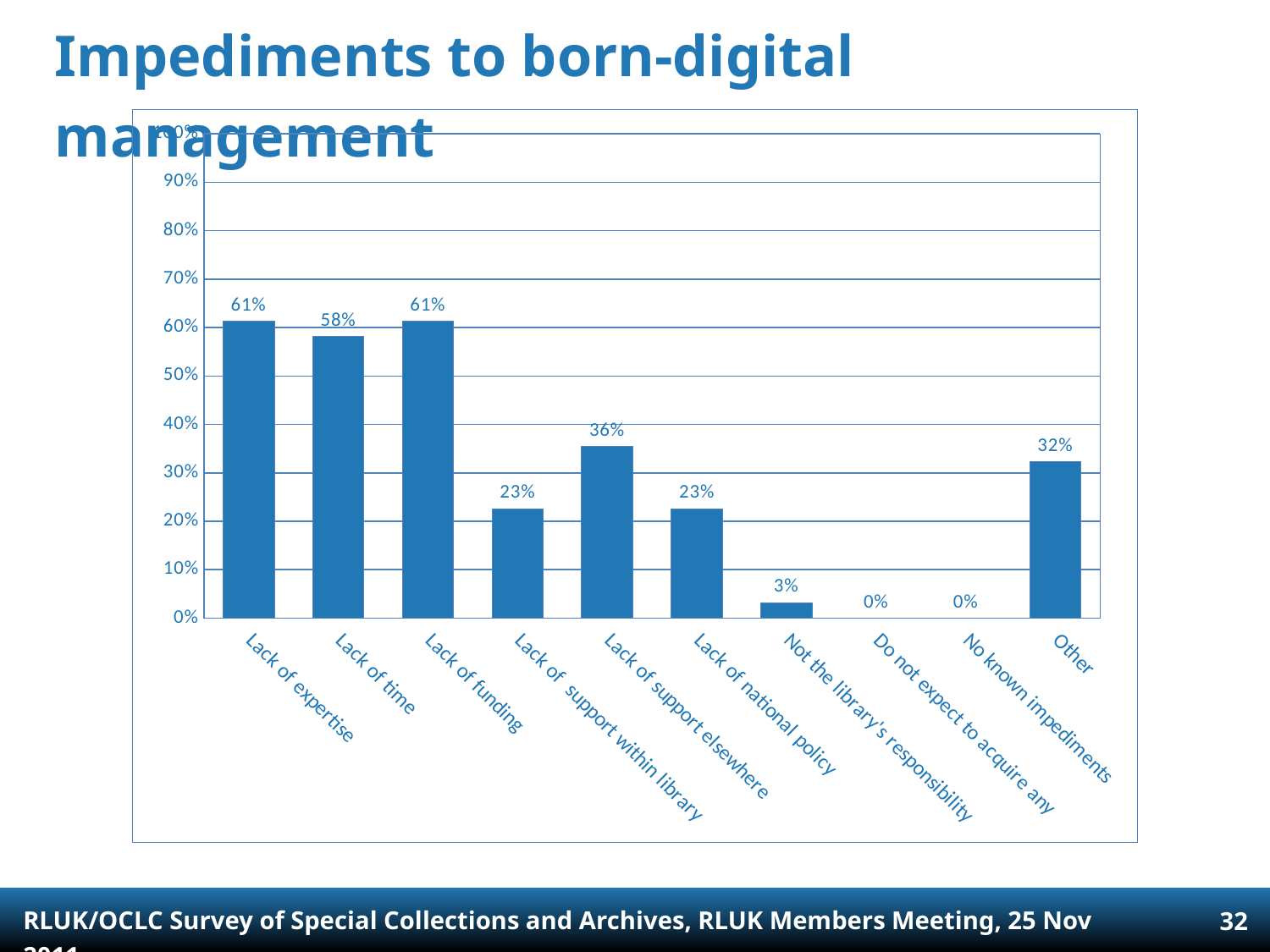
What is the value for Other? 32% How many categories are shown on the x axis? 10 Is the value for Lack of time greater or less than 50%? greater Which is larger, the value for Lack of funding or the value for Other? Lack of funding What kind of chart is shown on the slide? bar chart What is the value for Lack of national policy? 23% What is the difference between the values for Lack of support elsewhere and Lack of support within library? 13% What is the value for Lack of support elsewhere? 36% What is the difference between the values for Lack of expertise and Lack of time? 3% What is the value for Not the library's responsibility? 3% What is the value for Lack of time? 58% What is the title of the slide? Impediments to born-digital management